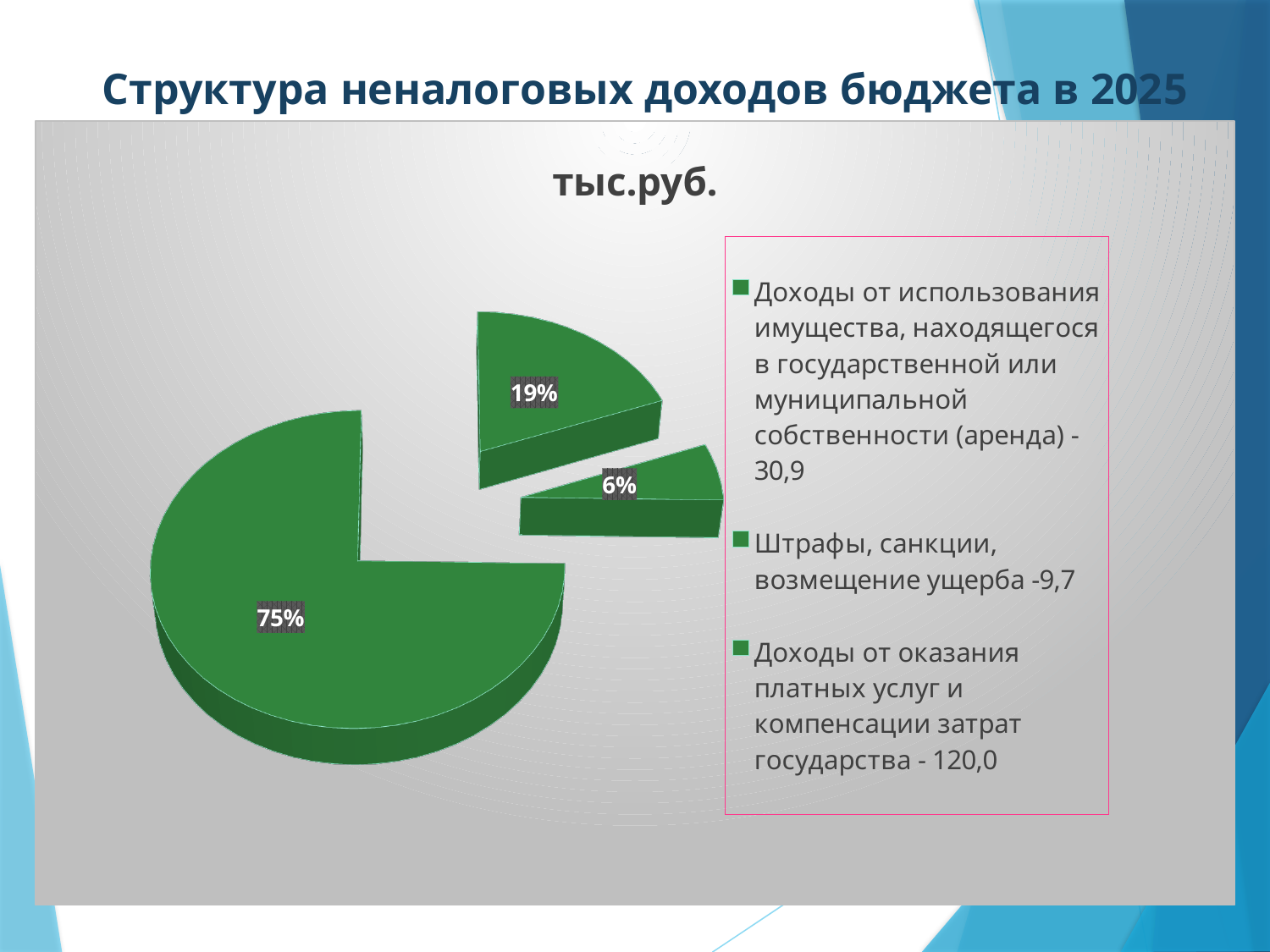
What is the share of the largest slice of the pie chart? 75% What value is given in the legend for "Доходы от оказания платных услуг и компенсации затрат государства"? 120,0 What is the title shown above the pie chart? тыс.руб. What kind of chart is shown on the slide? pie chart What value is given in the legend for "Штрафы, санкции, возмещение ущерба"? 9,7 What is the share of the smallest slice of the pie chart? 6% What share does the middle-sized slice of the pie chart represent? 19% How many entries does the legend of the pie chart list? 3 Which legend category has the largest value? Доходы от оказания платных услуг и компенсации затрат государства What value is given in the legend for "Доходы от использования имущества, находящегося в государственной или муниципальной собственности (аренда)"? 30,9 How many slices does the pie chart have? 3 Which is larger: the value for "Доходы от использования имущества ... (аренда)" or the value for "Штрафы, санкции, возмещение ущерба"? Доходы от использования имущества ... (аренда)